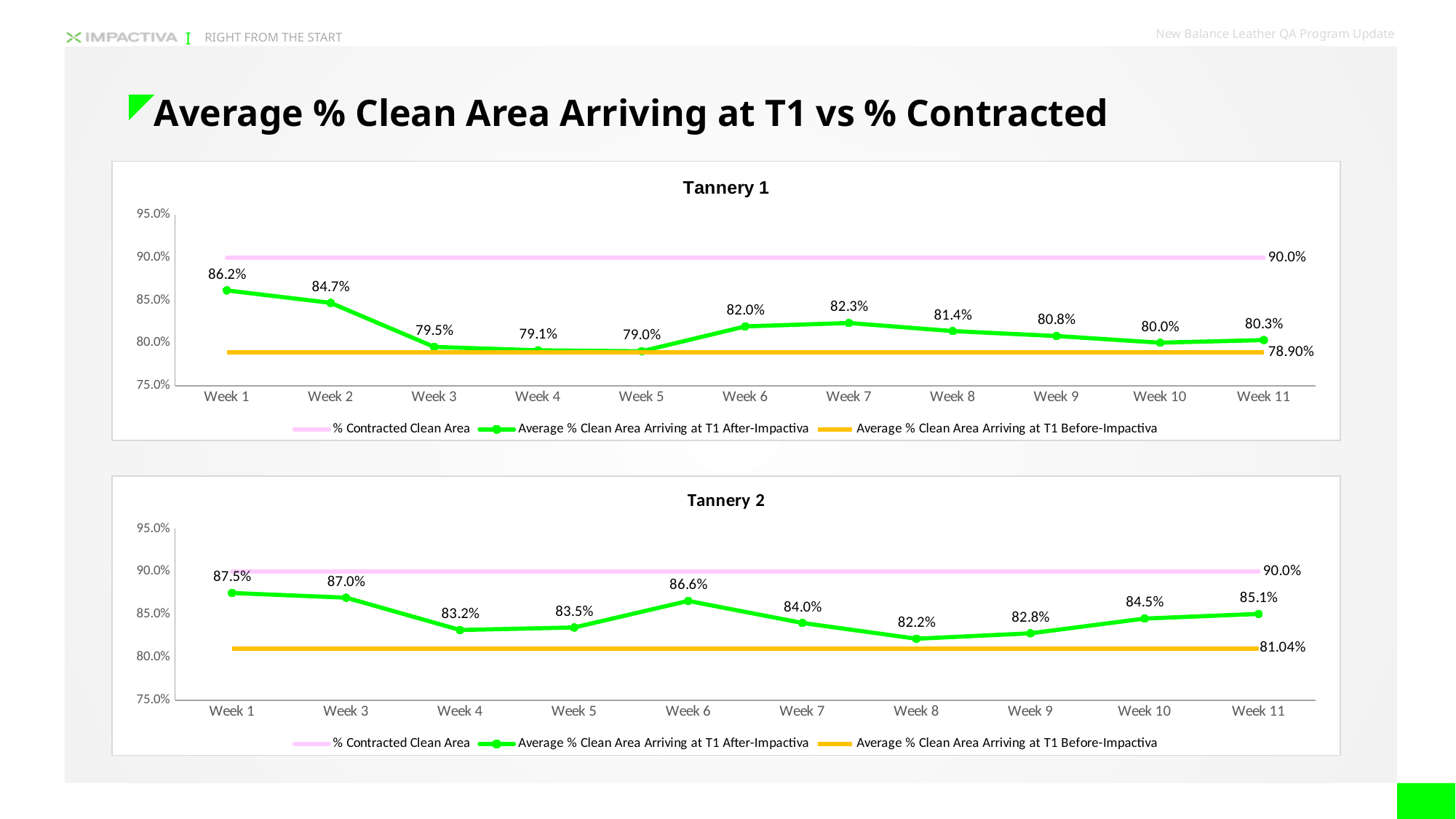
In the Tannery 1 chart, which week has the lowest Average % Clean Area Arriving at T1 After-Impactiva? Week 5 In the Tannery 1 chart, how many weeks are shown on the x axis? 11 In the Tannery 2 chart, what value is shown for Average % Clean Area Arriving at T1 Before-Impactiva? 81.04% In the Tannery 1 chart, what is the Average % Clean Area Arriving at T1 After-Impactiva for Week 1? 86.2% In the Tannery 2 chart, what is the Average % Clean Area Arriving at T1 After-Impactiva for Week 6? 86.6% In the Tannery 1 chart, what value is shown for Average % Clean Area Arriving at T1 Before-Impactiva? 78.90% How many series does the legend of the Tannery 2 chart list? 3 In the Tannery 2 chart, is the After-Impactiva value for Week 10 larger or smaller than the value for Week 9? larger In the Tannery 2 chart, which week has the highest Average % Clean Area Arriving at T1 After-Impactiva? Week 1 In the Tannery 1 chart, what is the difference between the Week 1 and Week 11 values of the After-Impactiva series? 5.9% What type of chart is the Tannery 1 chart? Line chart In the Tannery 2 chart, which week has the lowest Average % Clean Area Arriving at T1 After-Impactiva? Week 8